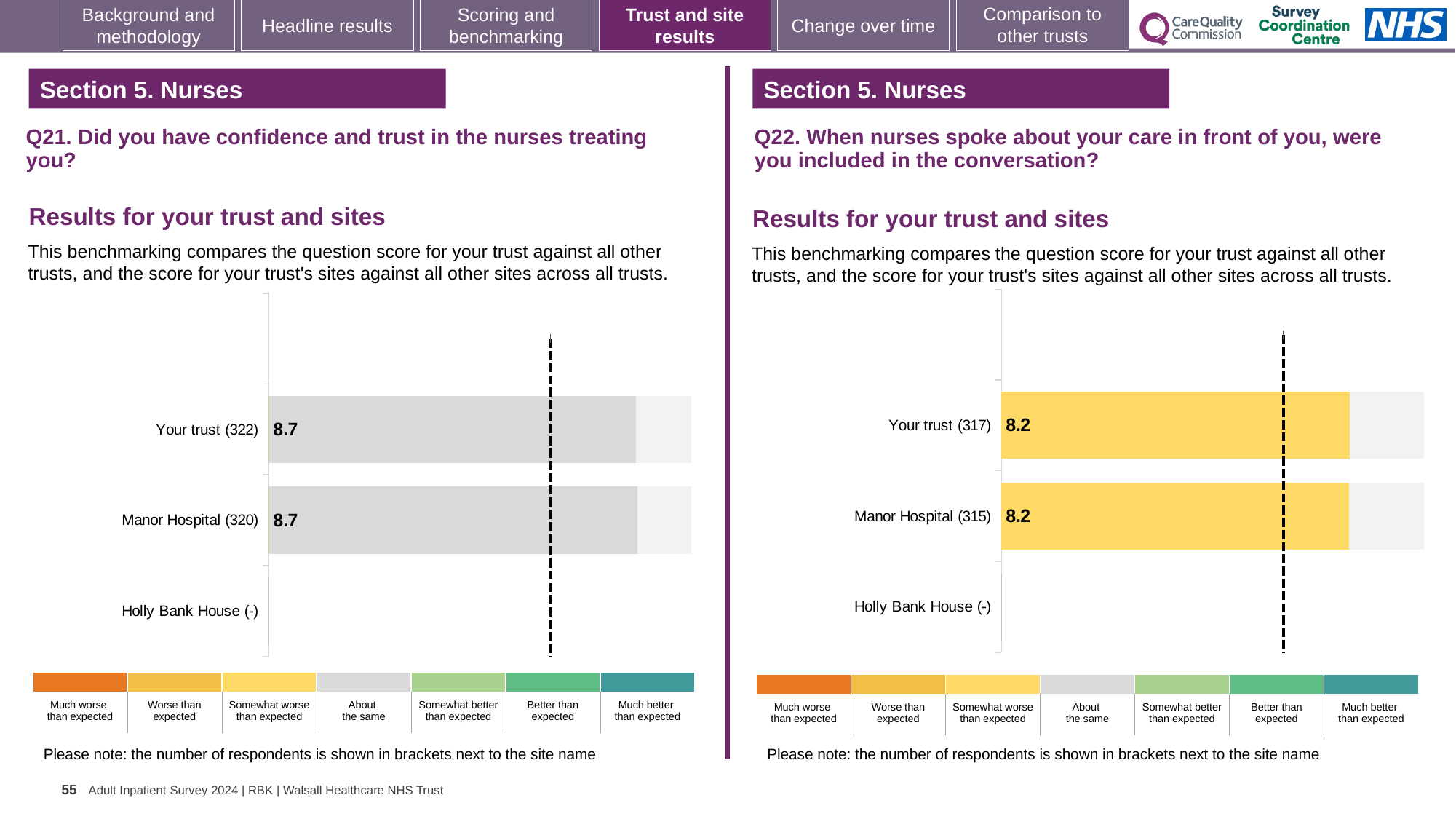
In the Q22 chart on the right, what is the score for Manor Hospital? 8.2 In the Q21 chart on the left, what is the score for Manor Hospital? 8.7 Which is larger: the Your trust score in the Q21 chart on the left or the Your trust score in the Q22 chart on the right? Q21 (8.7) In the Q21 chart on the left, what is the difference between the scores for Your trust and Manor Hospital? 0 In the Q21 chart on the left, how many respondents are shown in brackets for Your trust? 322 In the Q22 chart on the right, how many respondents are shown in brackets for Manor Hospital? 315 In the Q22 chart on the right, what is the score for Your trust? 8.2 In the Q21 chart on the left, what is the score for Your trust? 8.7 How many site/trust categories are listed on the y axis of the Q22 chart on the right? 3 What kind of chart is used in the Q21 chart on the left? Bar chart In the Q22 chart on the right, which category has no score shown? Holly Bank House